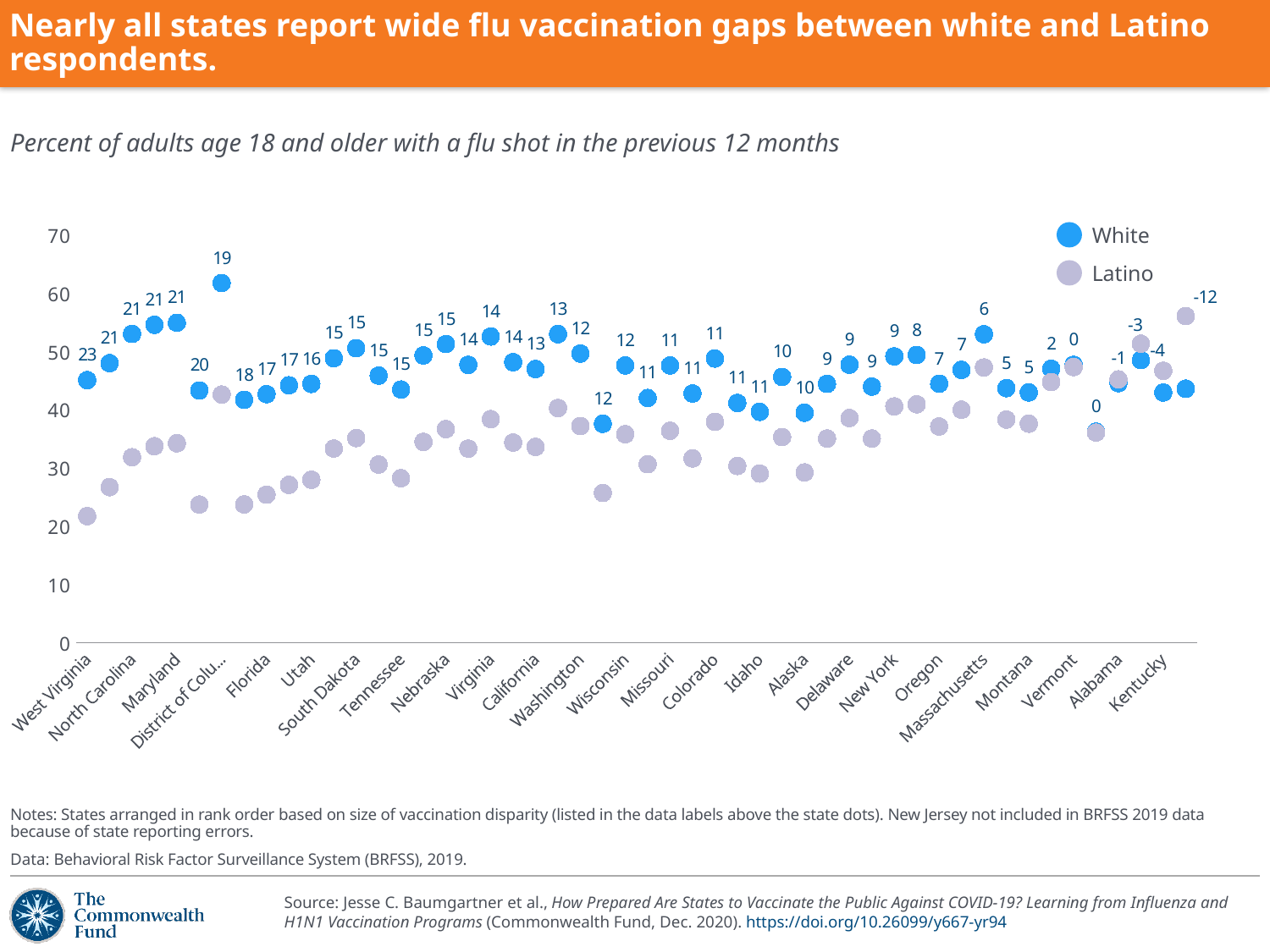
For West Virginia, which series has the higher value, White or Latino? White What is the disparity data label shown above the West Virginia dots? 23 How many states have a disparity data label of 21? 4 How many series does the legend list? 2 What kind of chart is shown on the slide? Dot (scatter) chart Is the White value for West Virginia greater or less than 40? greater Is the Latino value for West Virginia greater or less than 30? less What is the highest value shown on the y axis? 70 What is the lowest (most negative) disparity data label shown on the chart? -12 Do the disparity data labels generally rise or fall moving from left to right along the x axis? Fall Which state has the largest vaccination disparity label? West Virginia What are the two series named in the legend? White and Latino